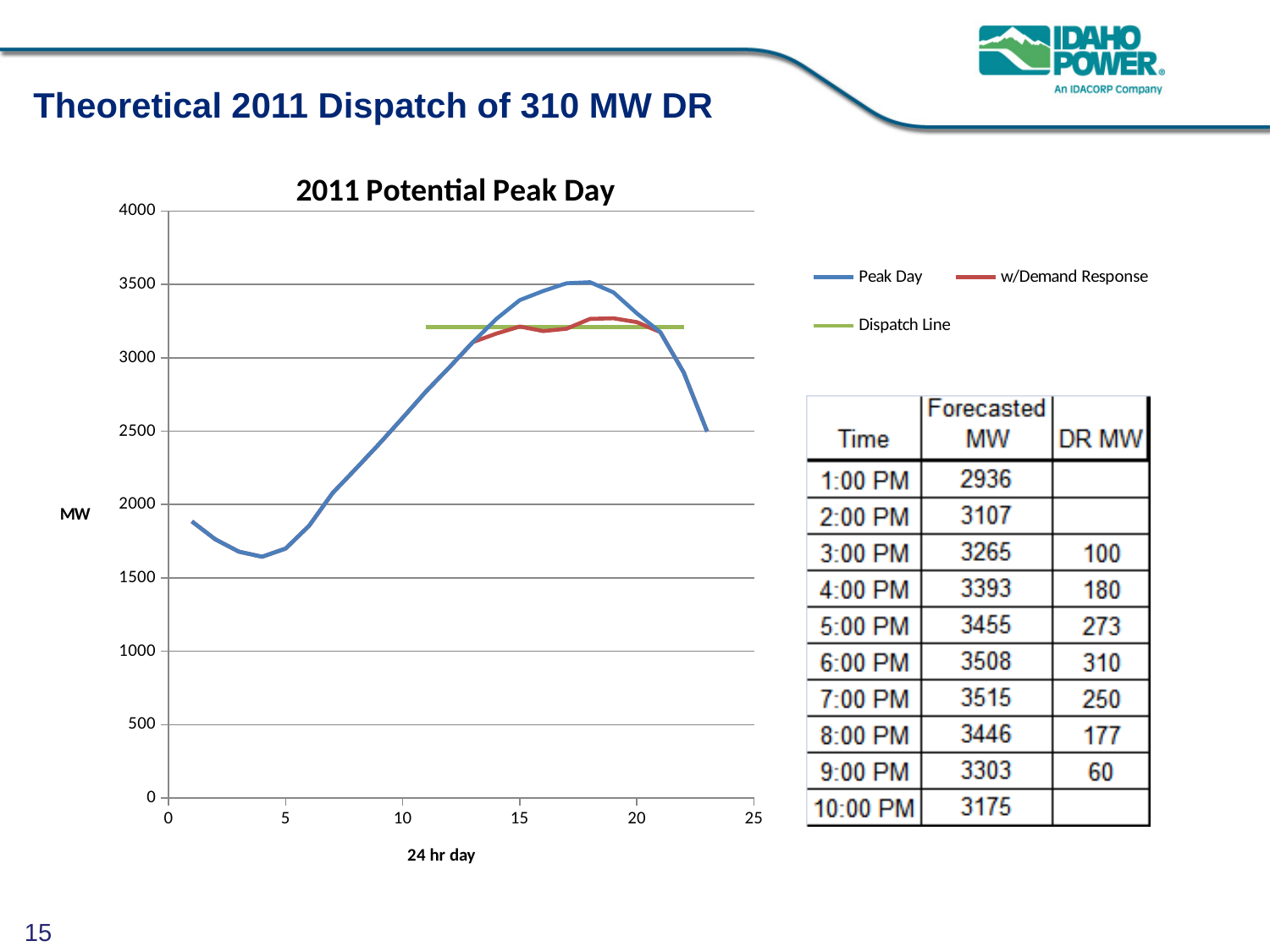
What is the title of the chart? 2011 Potential Peak Day Is the Peak Day value at hour 4 greater or less than 2000? less Is the Peak Day value at hour 23 greater or less than 3000? less What is the label on the chart's x axis? 24 hr day Is the Peak Day value at hour 18 greater or less than 3000? greater What kind of chart is shown on the slide? line chart Does the Peak Day series rise or fall between hour 18 and hour 23? fall At hour 15, which series is higher: Peak Day or w/Demand Response? Peak Day Does the Peak Day series rise or fall between hour 5 and hour 18? rise How many series does the chart legend list? 3